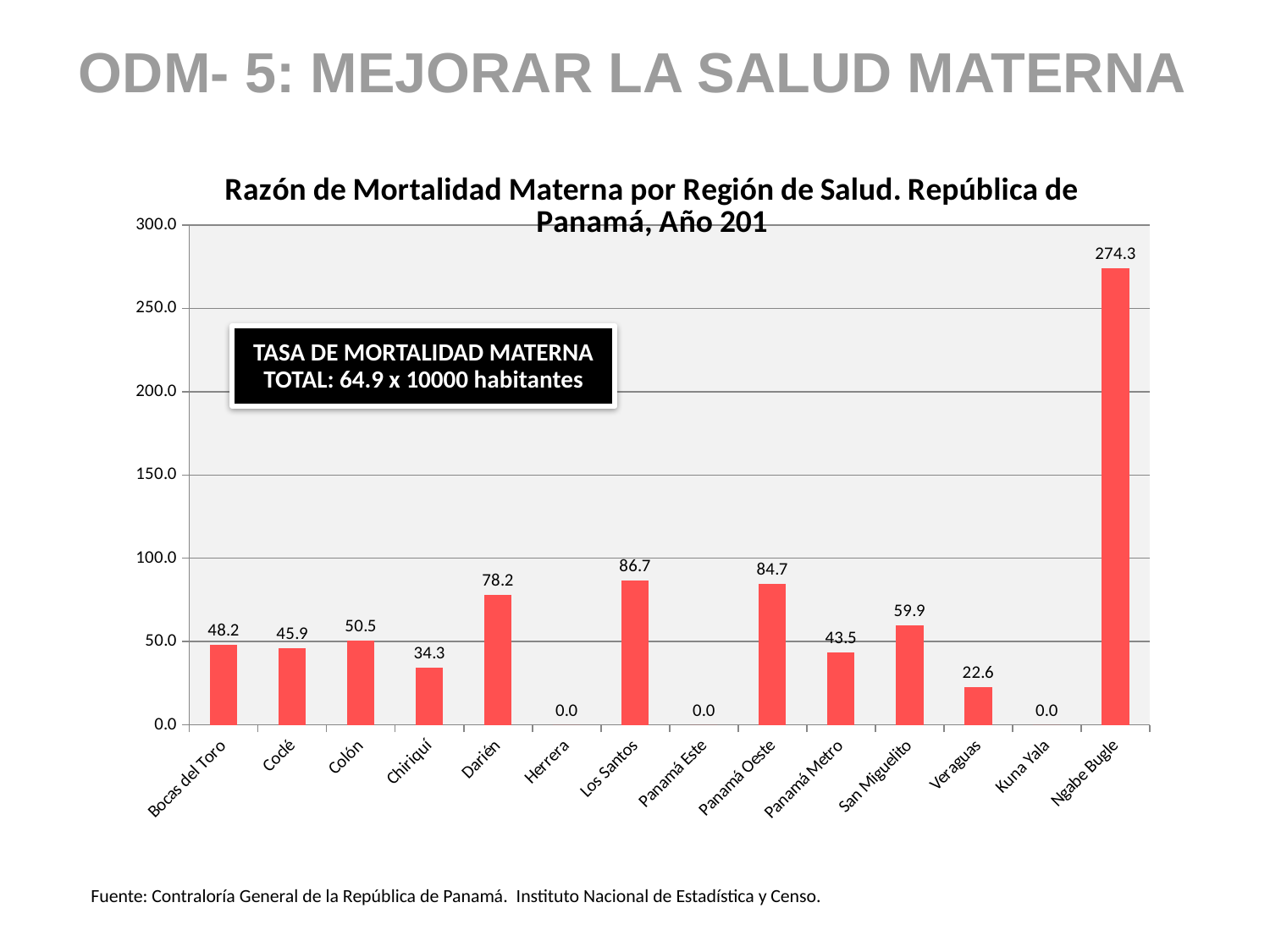
Which health region has the highest maternal mortality ratio? Ngabe Bugle What is the maternal mortality ratio for Ngabe Bugle? 274.3 What value is shown for Panamá Metro? 43.5 Is the value for Darién greater or less than 100.0? less Which is larger, the value for Colón or the value for Chiriquí? Colón What total maternal mortality rate is stated in the text box on the chart? 64.9 x 10000 habitantes What is the value for Veraguas? 22.6 What is the difference between the values for Los Santos and Panamá Oeste? 2.0 What value is shown for Darién? 78.2 How many health regions are shown on the x axis? 14 What is the difference between the values for Ngabe Bugle and San Miguelito? 214.4 What kind of chart is shown on the slide? Bar chart